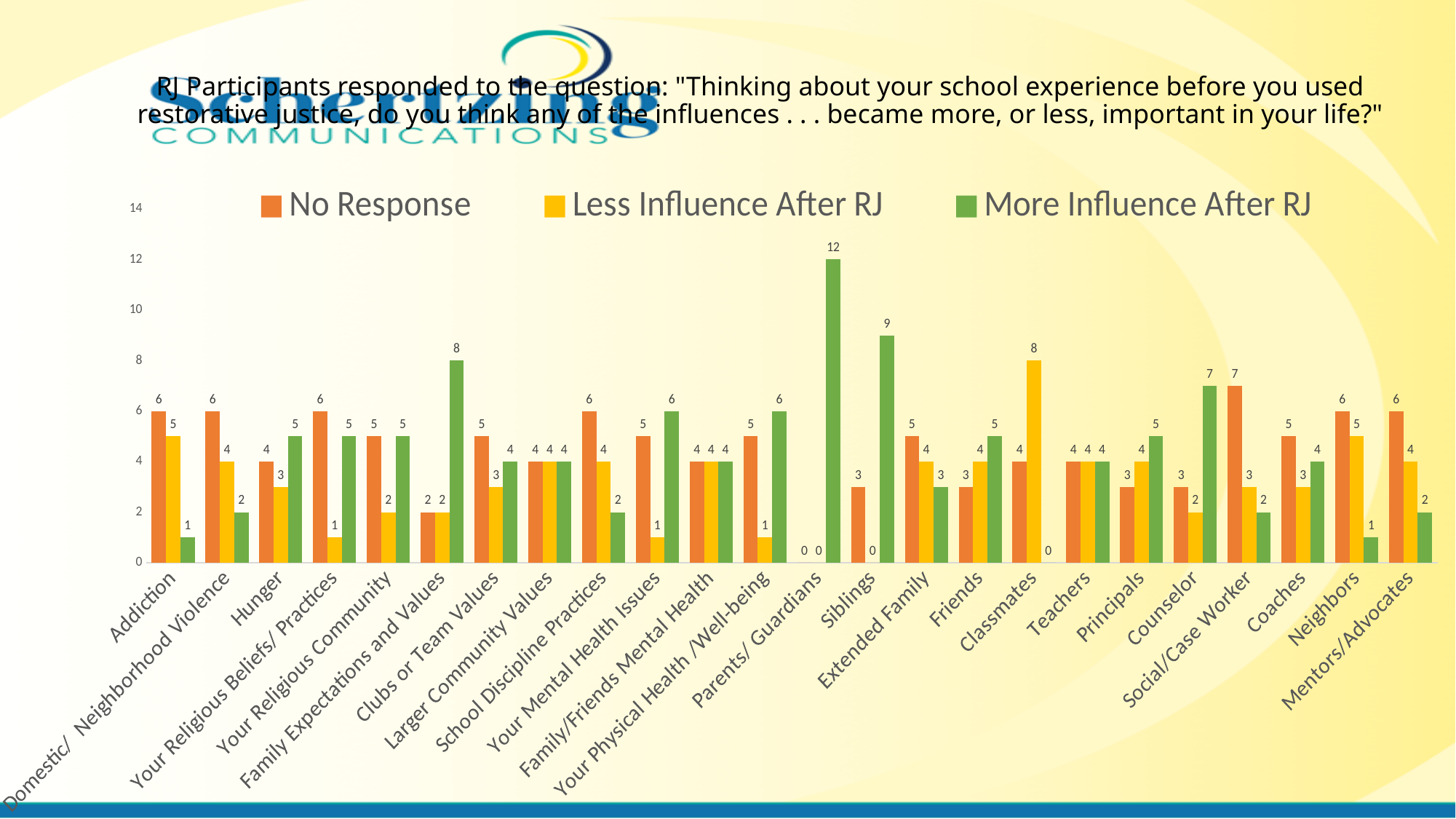
What is the No Response value for Social/Case Worker? 7 What is the More Influence After RJ value for Classmates? 0 Which series is shown in green in the legend? More Influence After RJ What is the Less Influence After RJ value for Classmates? 8 Which category has the highest More Influence After RJ value? Parents/ Guardians What is the More Influence After RJ value for Parents/ Guardians? 12 What is the difference between the More Influence After RJ values for Parents/ Guardians and Siblings? 3 What kind of chart is shown on the slide? Bar chart How many series does the legend list? 3 Which is larger for Counselor: the No Response value or the More Influence After RJ value? More Influence After RJ Which category has the highest Less Influence After RJ value? Classmates